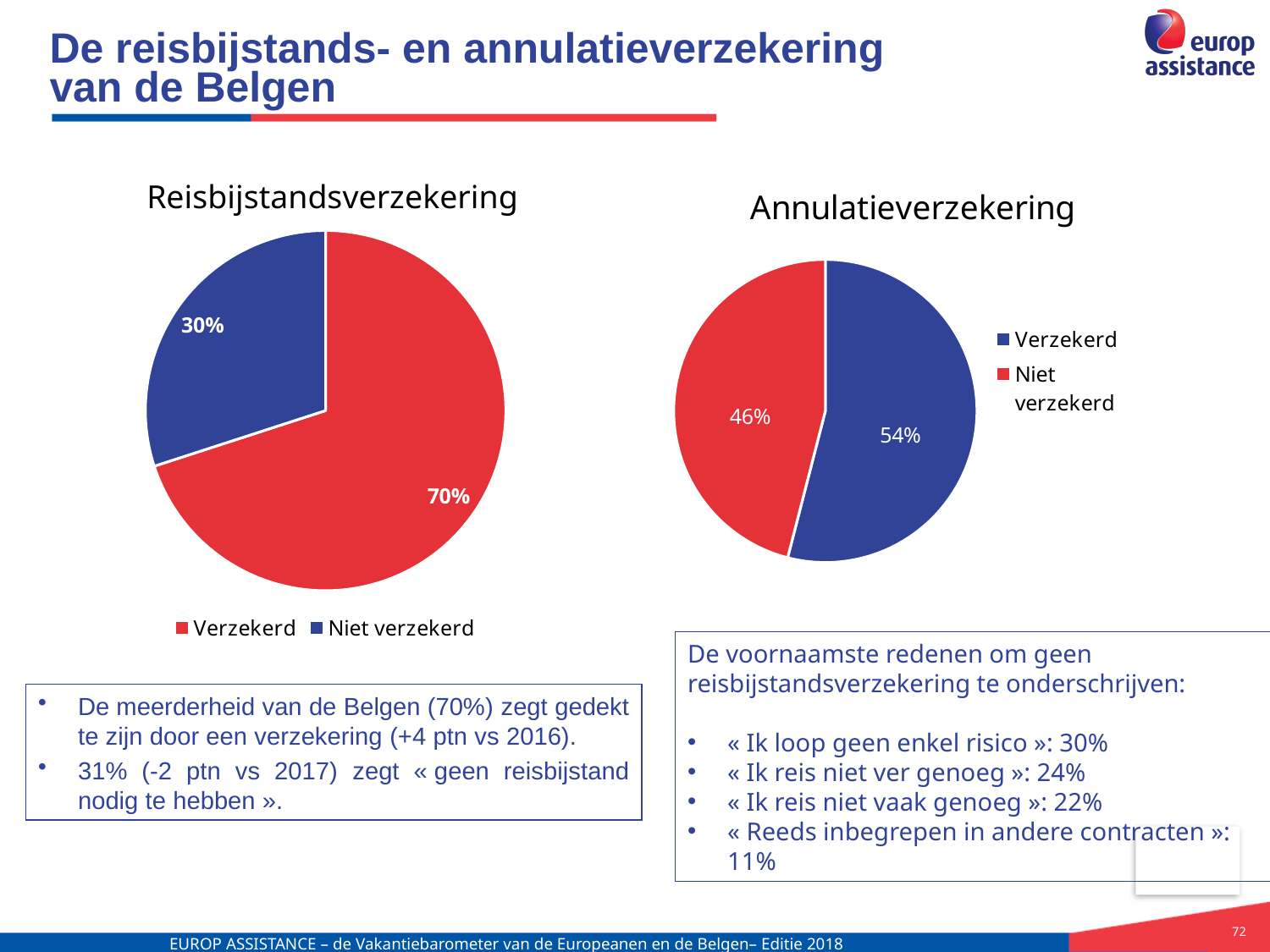
How many slices does the Reisbijstandsverzekering pie chart have? 2 In the Reisbijstandsverzekering chart, what share is Niet verzekerd? 30% In the Annulatieverzekering chart, which slice is the smallest? Niet verzekerd What type of chart is the Annulatieverzekering chart? Pie chart In the Annulatieverzekering chart, what colour is the Verzekerd slice? Blue In the Annulatieverzekering chart, what is the difference between the Verzekerd and Niet verzekerd shares? 8% In the Reisbijstandsverzekering chart, which slice is the largest? Verzekerd In the Annulatieverzekering chart, what share is Verzekerd? 54% Which is larger: the Verzekerd share in the Reisbijstandsverzekering chart or the Verzekerd share in the Annulatieverzekering chart? Reisbijstandsverzekering In the Annulatieverzekering chart, what share is Niet verzekerd? 46% In the Reisbijstandsverzekering chart, what share is Verzekerd? 70% In the Reisbijstandsverzekering chart, what is the difference between the Verzekerd and Niet verzekerd shares? 40%